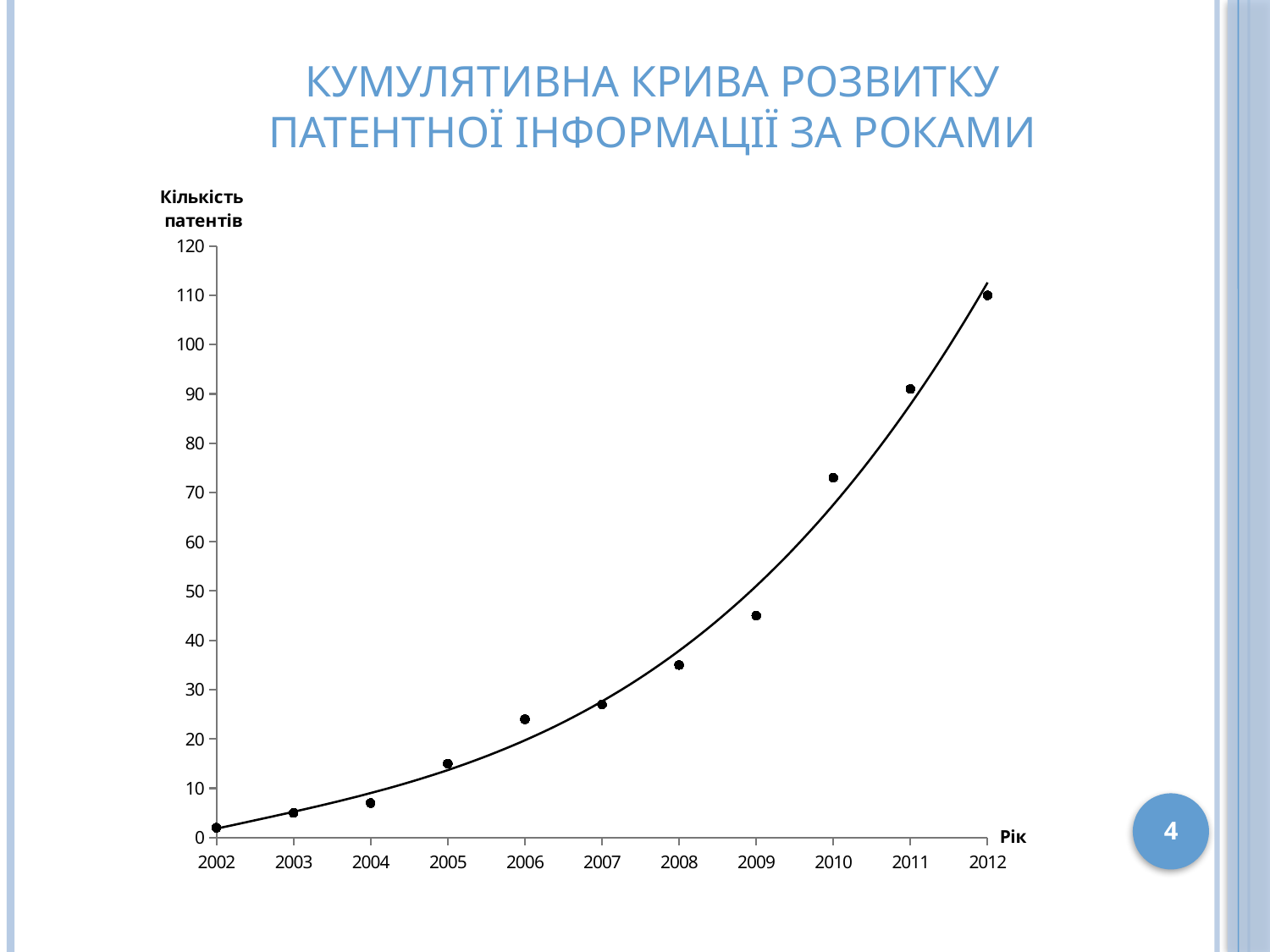
Is the value for 2010 greater or less than 70? greater Which year has the larger value, 2008 or 2010? 2010 What is the label of the horizontal axis? Рік What is the label of the vertical axis? Кількість патентів Is the value for 2011 greater or less than 100? less Which year has the highest number of patents? 2012 Is the value for 2006 greater or less than 20? greater What kind of chart is shown on the slide? scatter chart with a trend line Which year has the lowest number of patents? 2002 How many data points are plotted on the chart? 11 Do the values rise or fall from 2002 to 2012? rise